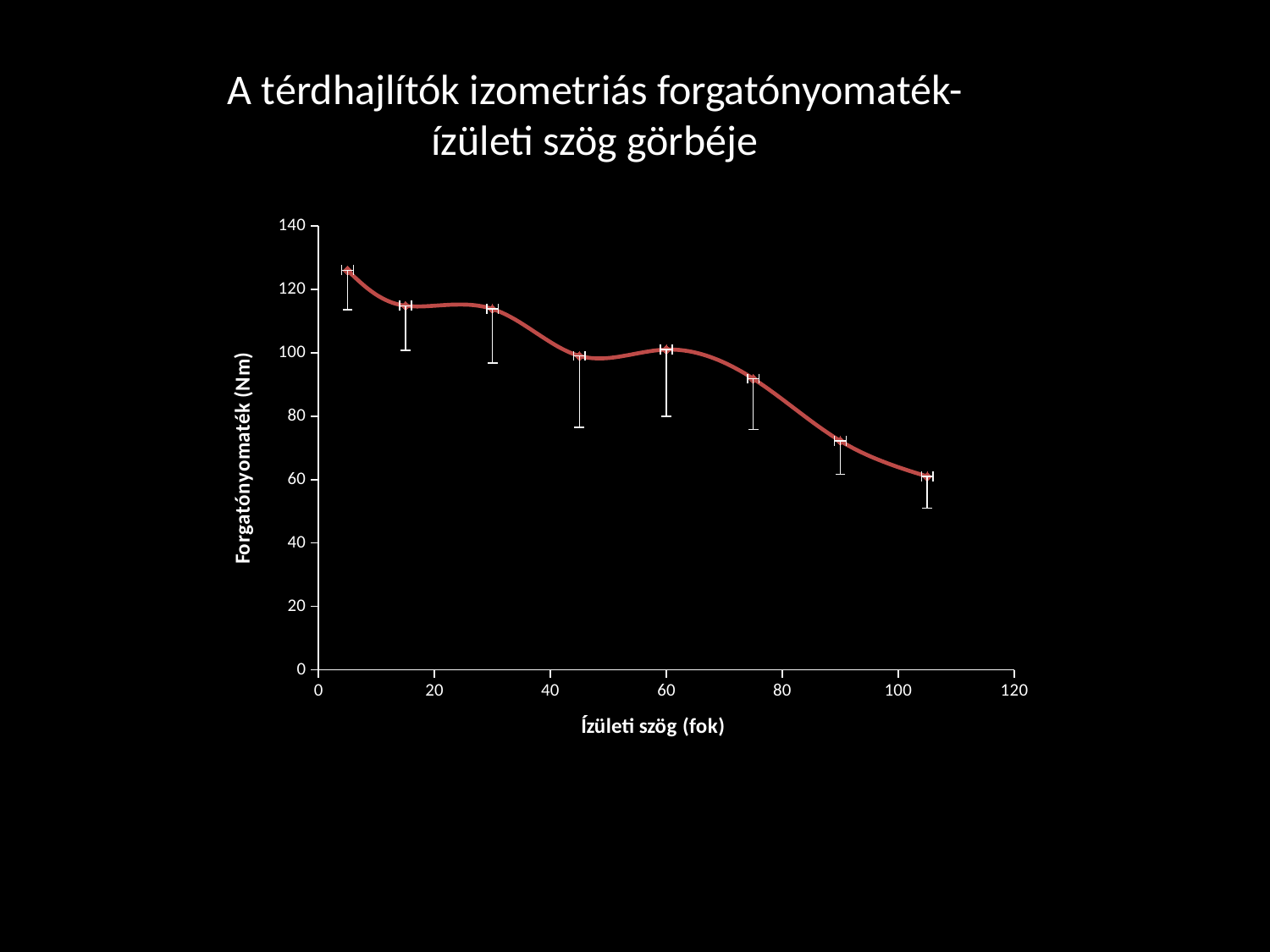
Is the torque value at a joint angle of 5 degrees greater or less than 120? greater At which joint angle is the torque lowest? 105 What is the title of the chart? A térdhajlítók izometriás forgatónyomaték-ízületi szög görbéje Which has the larger torque value: the point at 75 degrees or the point at 90 degrees? 75 degrees What is the label of the y axis? Forgatónyomaték (Nm) Do the torque values generally rise or fall as the joint angle increases along the x axis? fall At which joint angle is the torque highest? 5 Is the torque value at a joint angle of 15 degrees greater or less than 100? greater What kind of chart is shown on the slide? line chart How many data points are plotted on the curve? 8 Is the torque value at a joint angle of 105 degrees greater or less than 80? less